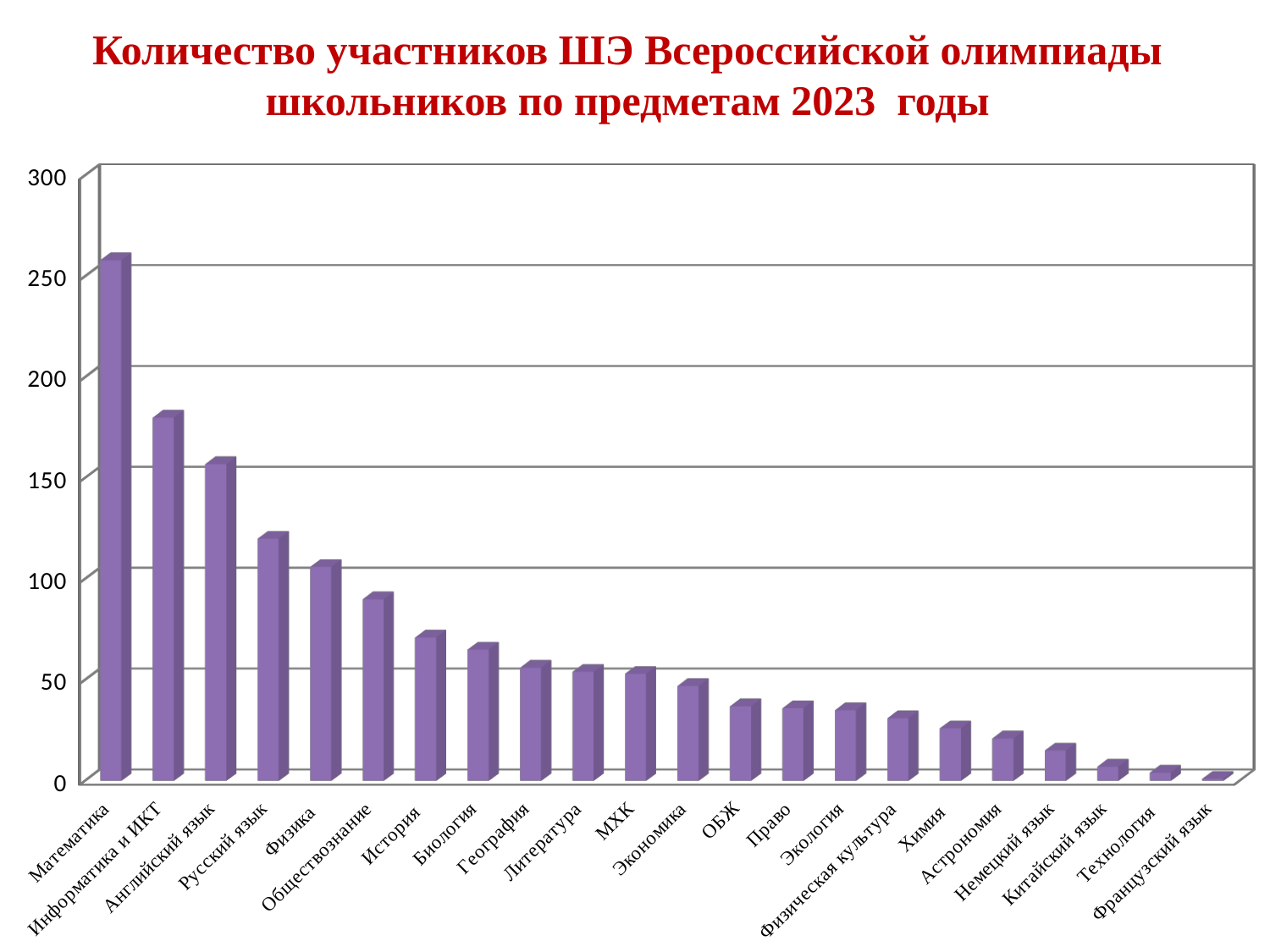
Is the value for История greater or less than 50? greater What kind of chart is shown on the slide? bar chart Is the value for Математика greater or less than 250? greater Do the values rise or fall moving from left to right along the x axis? fall Which has more participants, Английский язык or Русский язык? Английский язык Which subject has the highest number of participants? Математика Is the value for Русский язык greater or less than 100? greater What is the title of the chart? Количество участников ШЭ Всероссийской олимпиады школьников по предметам 2023 годы How many subjects (categories) are shown on the x axis? 22 Which subject has the lowest number of participants? Французский язык